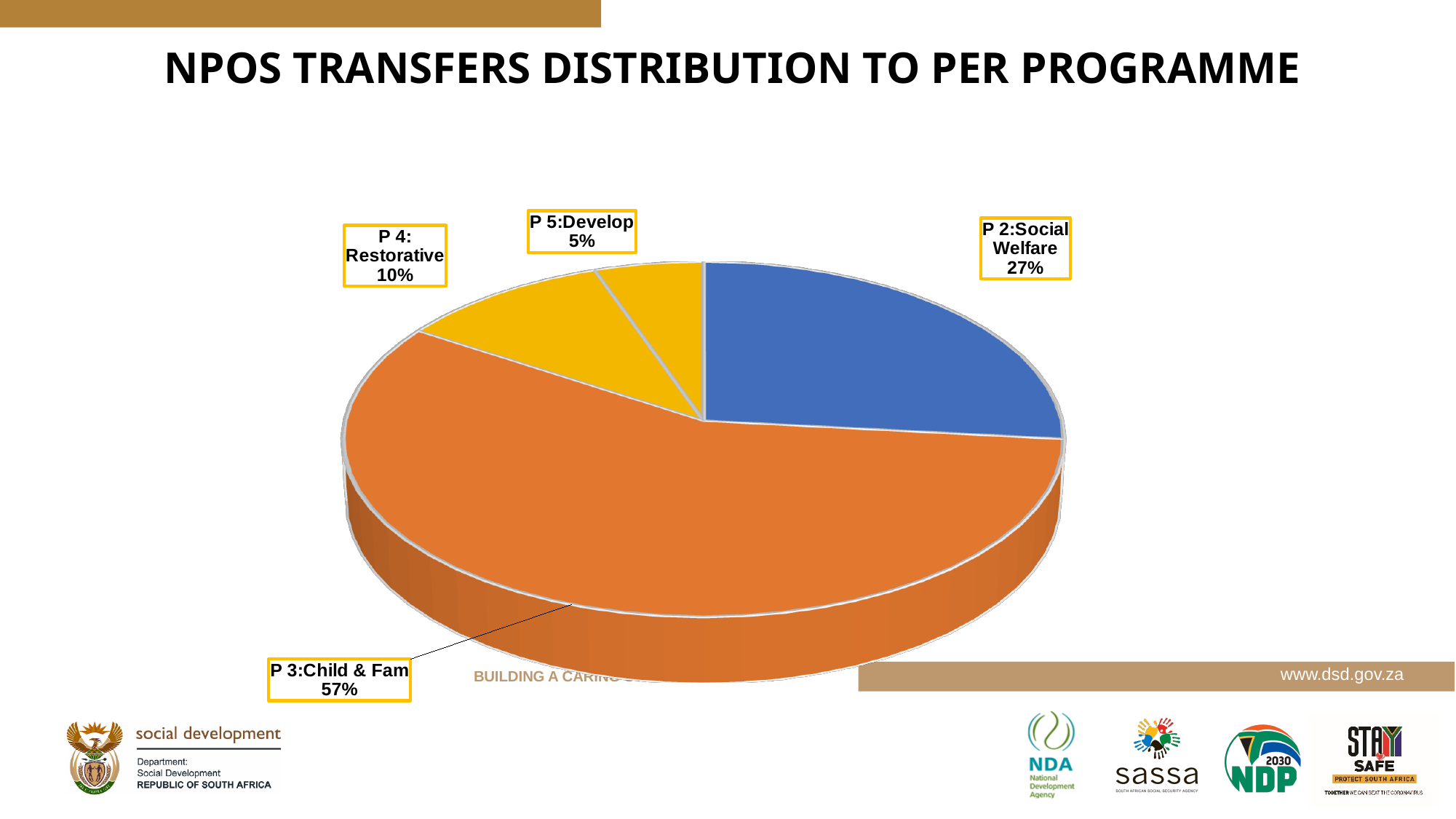
What share of NPO transfers goes to P 2:Social Welfare? 27% What share of NPO transfers goes to P 5:Develop? 5% What is the difference in percentage points between P 3:Child & Fam and P 2:Social Welfare? 30 Which programme receives the smallest share of NPO transfers? P 5:Develop Which receives a larger share, P 4: Restorative or P 5:Develop? P 4: Restorative How many programmes (slices) are shown in the pie chart? 4 What is the title of the chart on the slide? NPOS TRANSFERS DISTRIBUTION TO PER PROGRAMME Which programme receives the largest share of NPO transfers? P 3:Child & Fam What share of NPO transfers goes to P 4: Restorative? 10% What share of NPO transfers goes to P 3:Child & Fam? 57% What kind of chart is shown on the slide? Pie chart What is the difference in percentage points between P 4: Restorative and P 5:Develop? 5